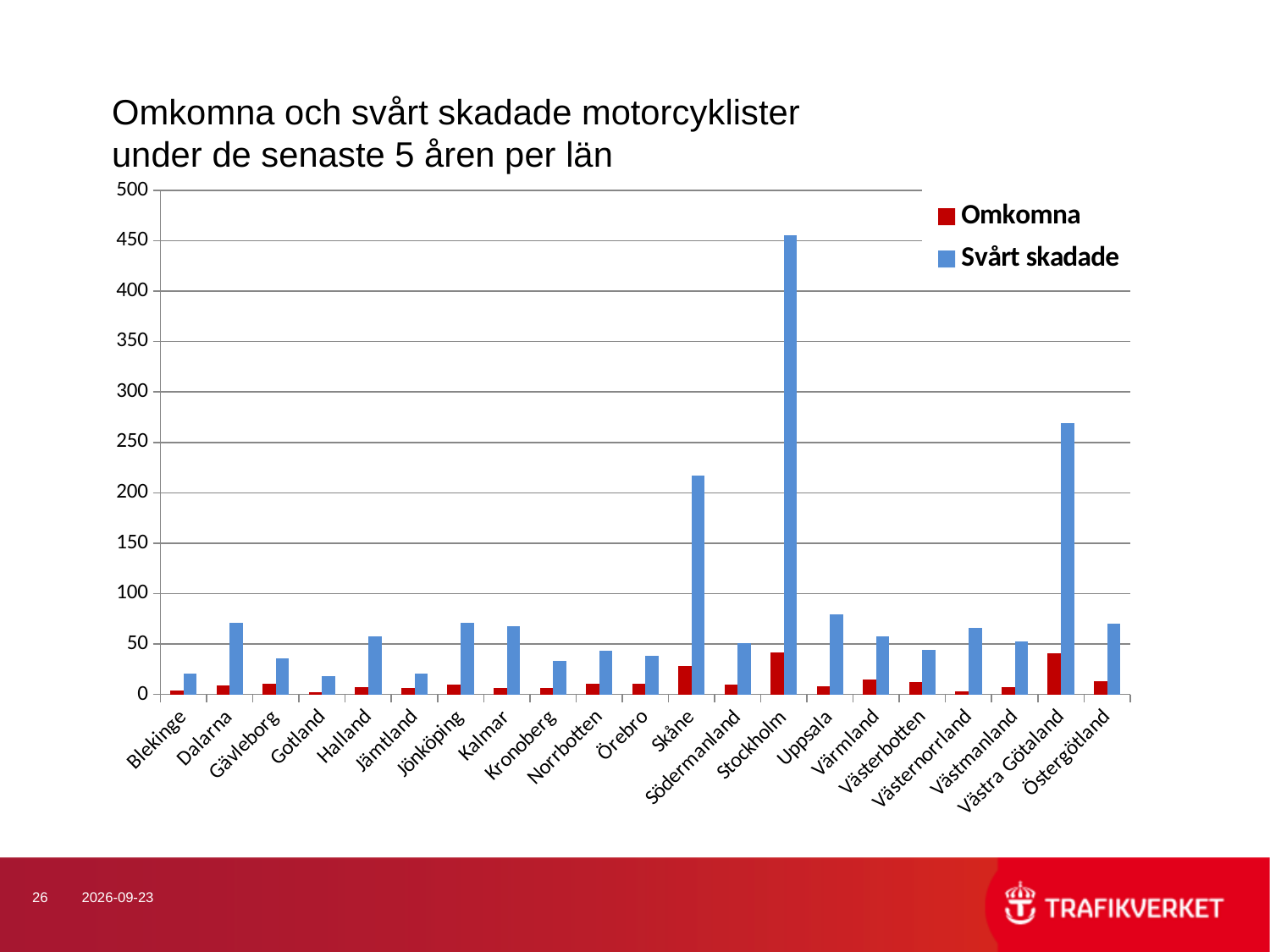
Is the Svårt skadade value for Uppsala greater or less than 50? greater Which has the larger Svårt skadade value, Skåne or Västra Götaland? Västra Götaland Is the Svårt skadade value for Skåne greater or less than 200? greater Which county has the highest value for Svårt skadade? Stockholm How many series does the legend list? 2 Is the Svårt skadade value for Stockholm greater or less than 400? greater Which series is shown in red? Omkomna What kind of chart is shown on the slide? bar chart Which has the larger Svårt skadade value, Dalarna or Gävleborg? Dalarna How many counties (län) are shown on the x axis? 21